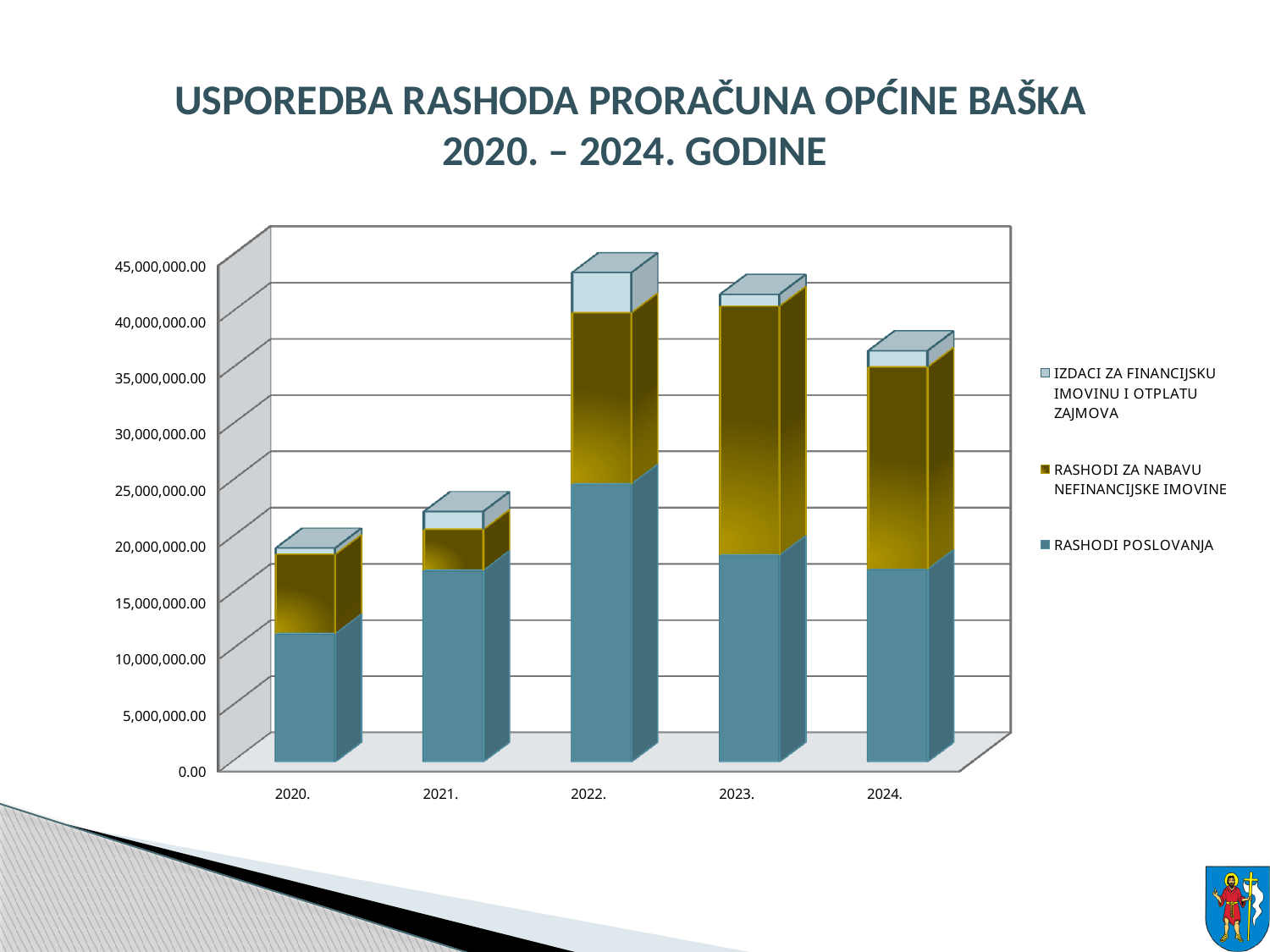
Is the total for 2022. greater or less than 40,000,000.00? greater Is the total for 2021. greater or less than 25,000,000.00? less Which year has the highest total expenditure in the chart? 2022. Is the RASHODI POSLOVANJA value for 2020. greater or less than 15,000,000.00? less Which year has the larger total expenditure, 2023. or 2024.? 2023. Do the total expenditures rise or fall from 2020. to 2022.? rise What is the title of the chart on the slide? USPOREDBA RASHODA PRORAČUNA OPĆINE BAŠKA 2020. – 2024. GODINE How many years (categories) are shown on the x axis of the chart? 5 What kind of chart is shown on the slide? Stacked bar chart Which year has the lowest total expenditure in the chart? 2020. How many series does the chart legend list? 3